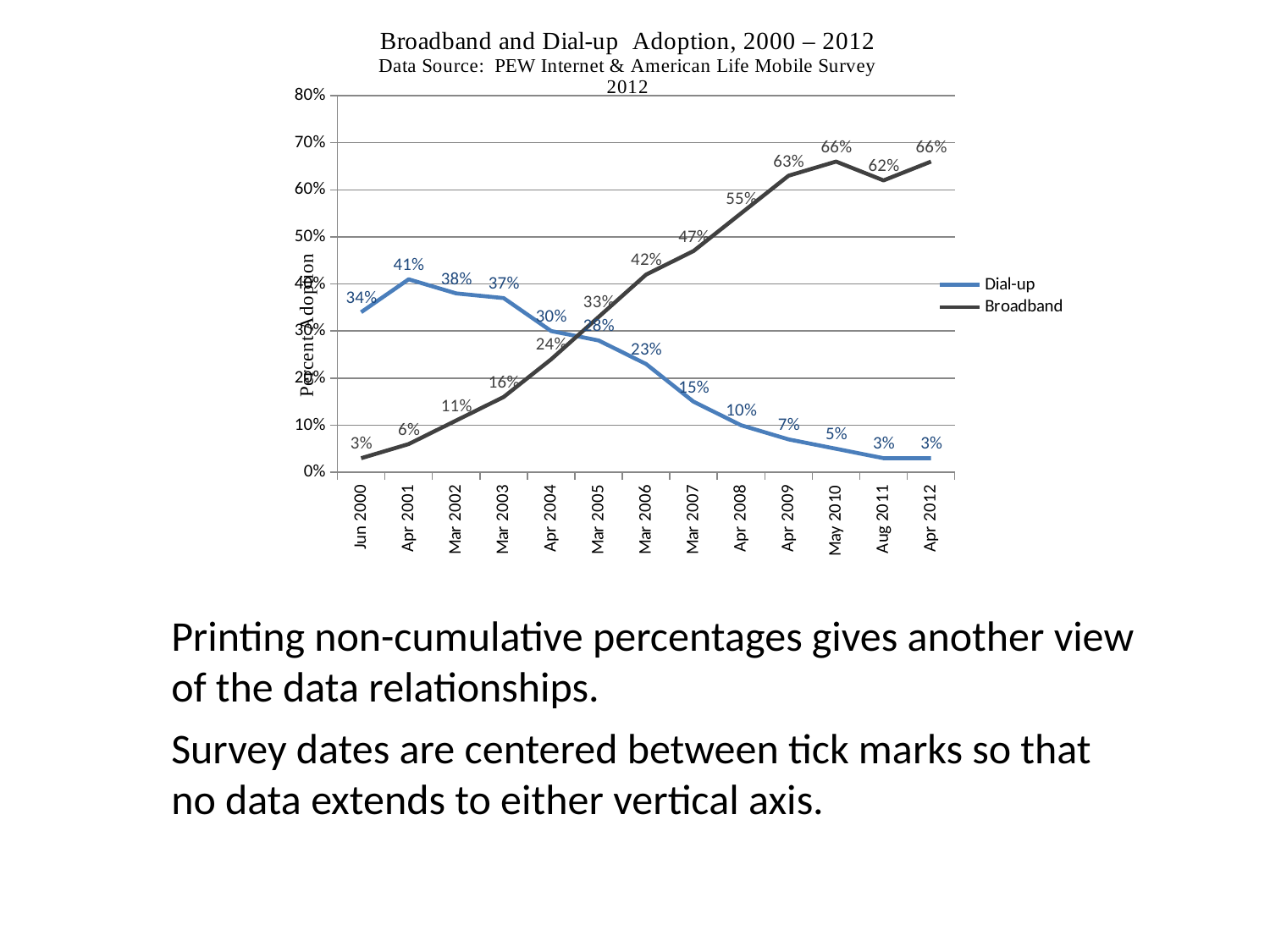
What is the Broadband value for Apr 2009? 63% In which survey period is the Broadband value lowest? Jun 2000 In which survey period does the Dial-up series reach its highest value? Apr 2001 By how much did the Dial-up value fall from Apr 2001 to Mar 2002? 3% In Mar 2005, which series has the higher value, Dial-up or Broadband? Broadband What is the Broadband value for Aug 2011? 62% How many survey dates are plotted along the x axis? 13 What is the Dial-up value for Jun 2000? 34% What is the difference between the Broadband and Dial-up values in Apr 2012? 63% How many series does the legend list? 2 Does the Broadband series generally rise or fall from Jun 2000 to Apr 2012? Rise What kind of chart is shown on the slide? Line chart